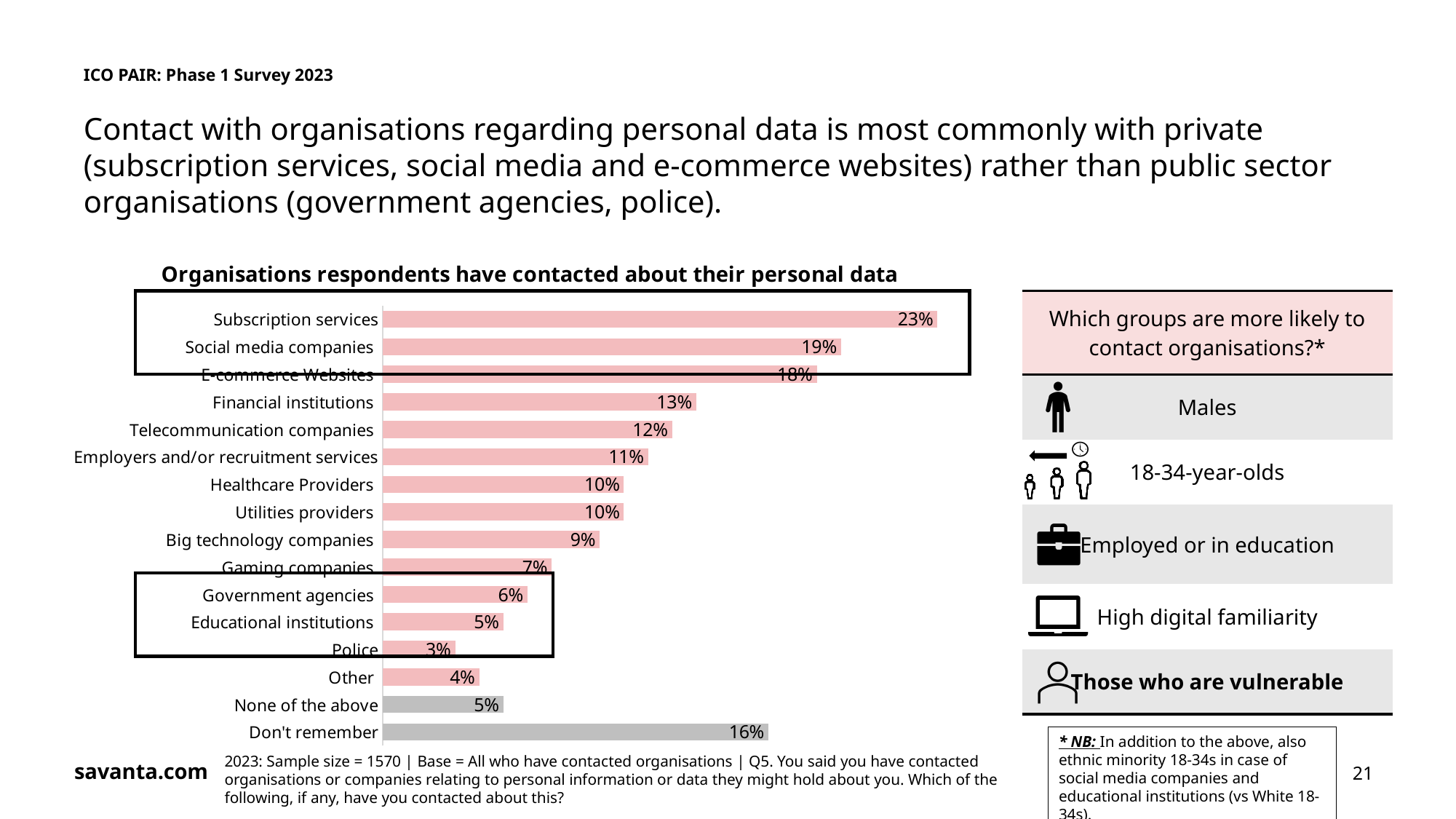
What is the value shown for Financial institutions? 13% How many categories (bars) are shown in the chart? 16 What is the value for 'Don't remember'? 16% What percentage of respondents contacted the Police? 3% Which two bars are coloured grey rather than pink? None of the above and Don't remember What is the title of the chart? Organisations respondents have contacted about their personal data Which has a higher value: Telecommunication companies or Big technology companies? Telecommunication companies What percentage of respondents have contacted subscription services about their personal data? 23% What type of chart is used on this slide? Bar chart Which organisation type has the highest percentage of respondents contacting it? Subscription services Which organisation type has the lowest percentage in the chart? Police What is the difference in percentage points between Social media companies and Government agencies? 13